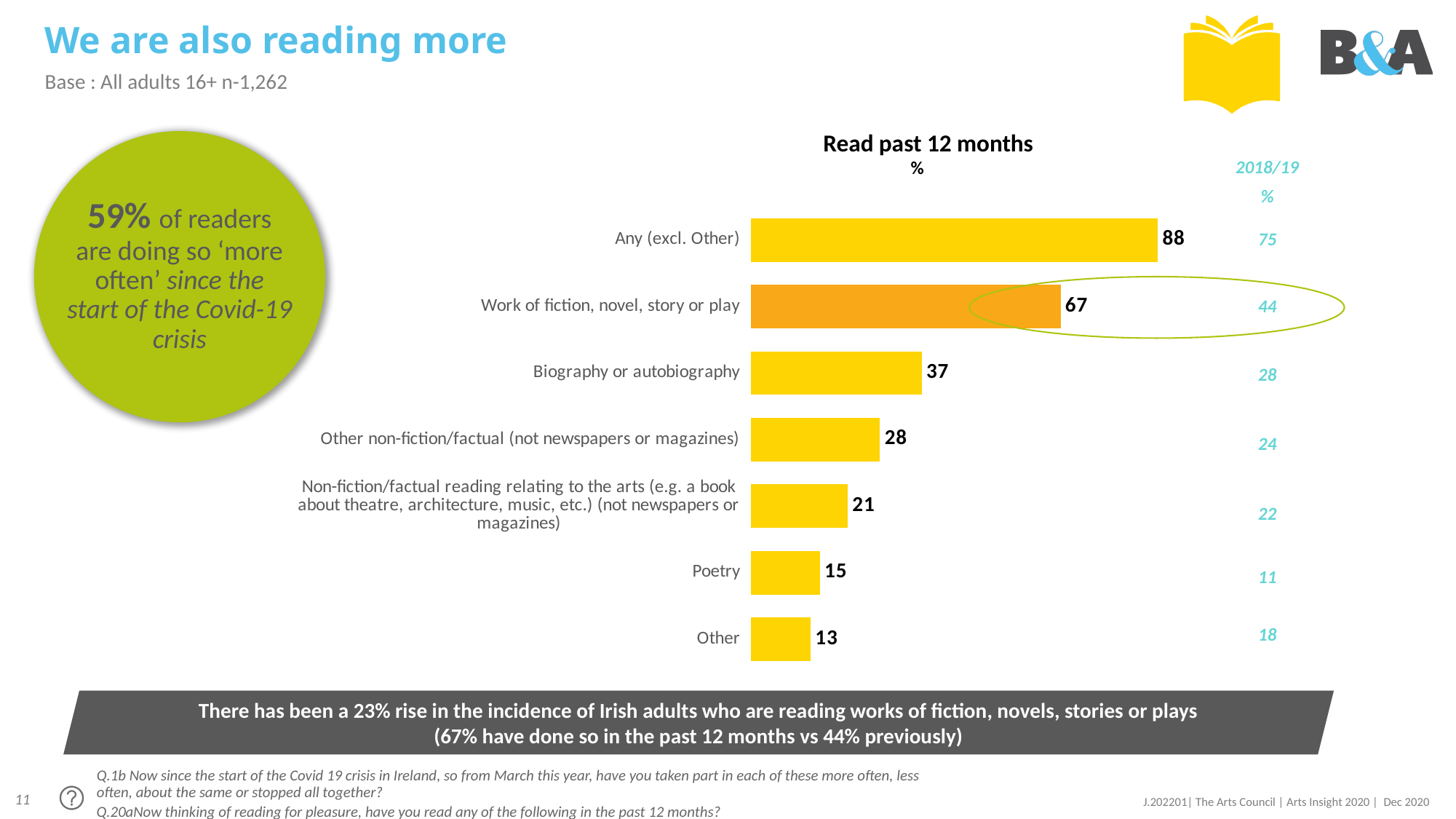
What is the difference between the values for 'Biography or autobiography' and 'Other non-fiction/factual (not newspapers or magazines)'? 9 Which category has the lowest value in the Read past 12 months chart? Other What is the value for 'Biography or autobiography' in the Read past 12 months chart? 37 How many categories are shown in the Read past 12 months chart? 7 What is the value for 'Work of fiction, novel, story or play' in the Read past 12 months chart? 67 What is the value for 'Poetry' in the Read past 12 months chart? 15 What was the 2018/19 % value for 'Work of fiction, novel, story or play'? 44 Which bar in the Read past 12 months chart is coloured orange rather than yellow? Work of fiction, novel, story or play Which has a larger value in the Read past 12 months chart: 'Poetry' or 'Other'? Poetry What is the difference between the values for 'Any (excl. Other)' and 'Work of fiction, novel, story or play' in the Read past 12 months chart? 21 What kind of chart is used to show 'Read past 12 months'? Bar chart Which category has the highest value in the Read past 12 months chart? Any (excl. Other)